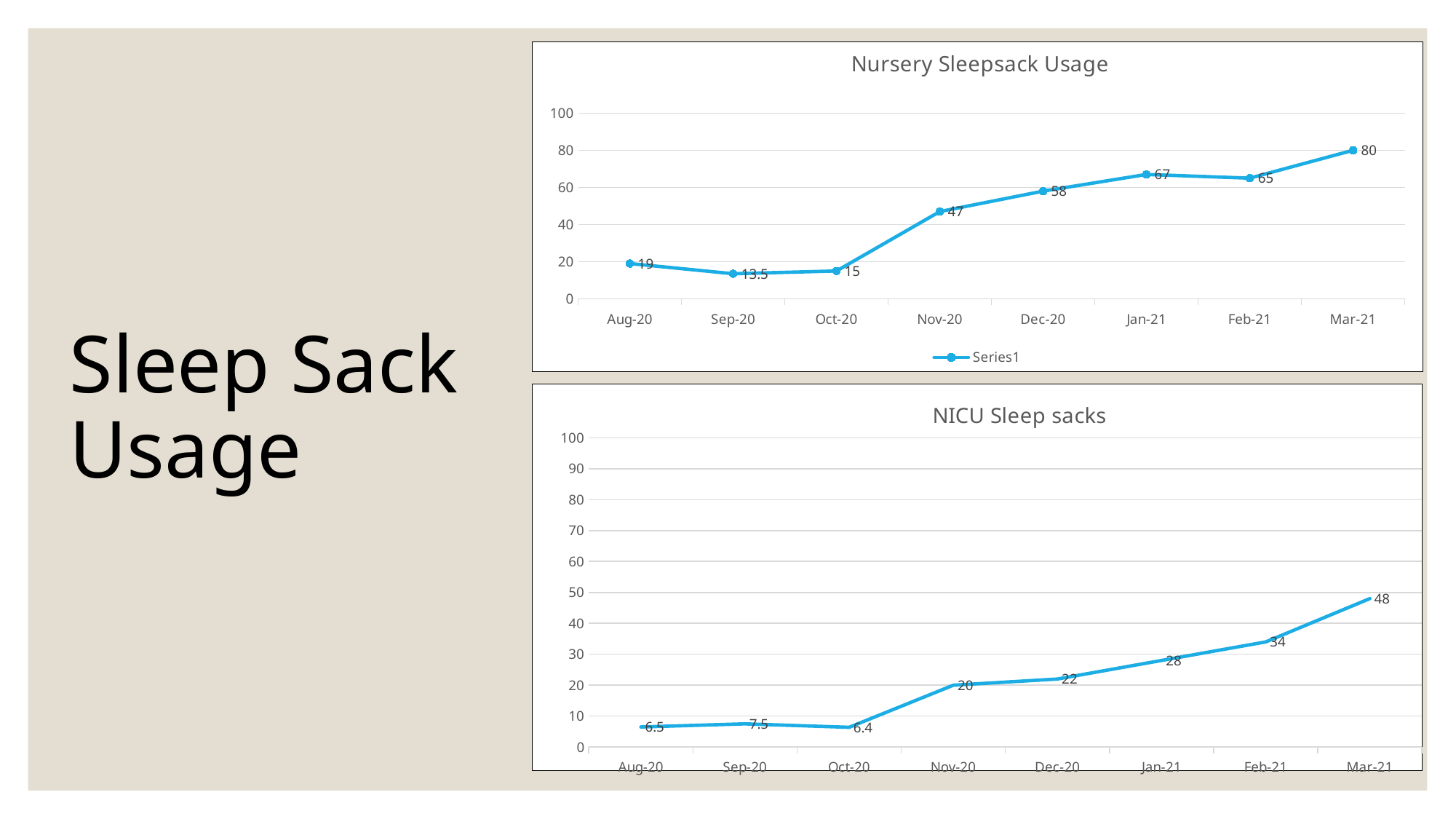
In the NICU Sleep sacks chart, what is the value for Feb-21? 34 In the Nursery Sleepsack Usage chart, how many data points are plotted? 8 In the NICU Sleep sacks chart, what is the value for Oct-20? 6.4 In the Nursery Sleepsack Usage chart, which month has the highest value? Mar-21 In the Nursery Sleepsack Usage chart, what is the difference between the Mar-21 and Aug-20 values? 61 In the NICU Sleep sacks chart, which month has the highest value? Mar-21 In the NICU Sleep sacks chart, what is the difference between the Mar-21 and Feb-21 values? 14 Which is larger: the Dec-20 value in the Nursery Sleepsack Usage chart or the Dec-20 value in the NICU Sleep sacks chart? Nursery Sleepsack Usage What type of chart is the NICU Sleep sacks chart? Line chart In the Nursery Sleepsack Usage chart, which month has the lowest value? Sep-20 In the Nursery Sleepsack Usage chart, what is the value for Nov-20? 47 In the Nursery Sleepsack Usage chart, what is the value for Sep-20? 13.5